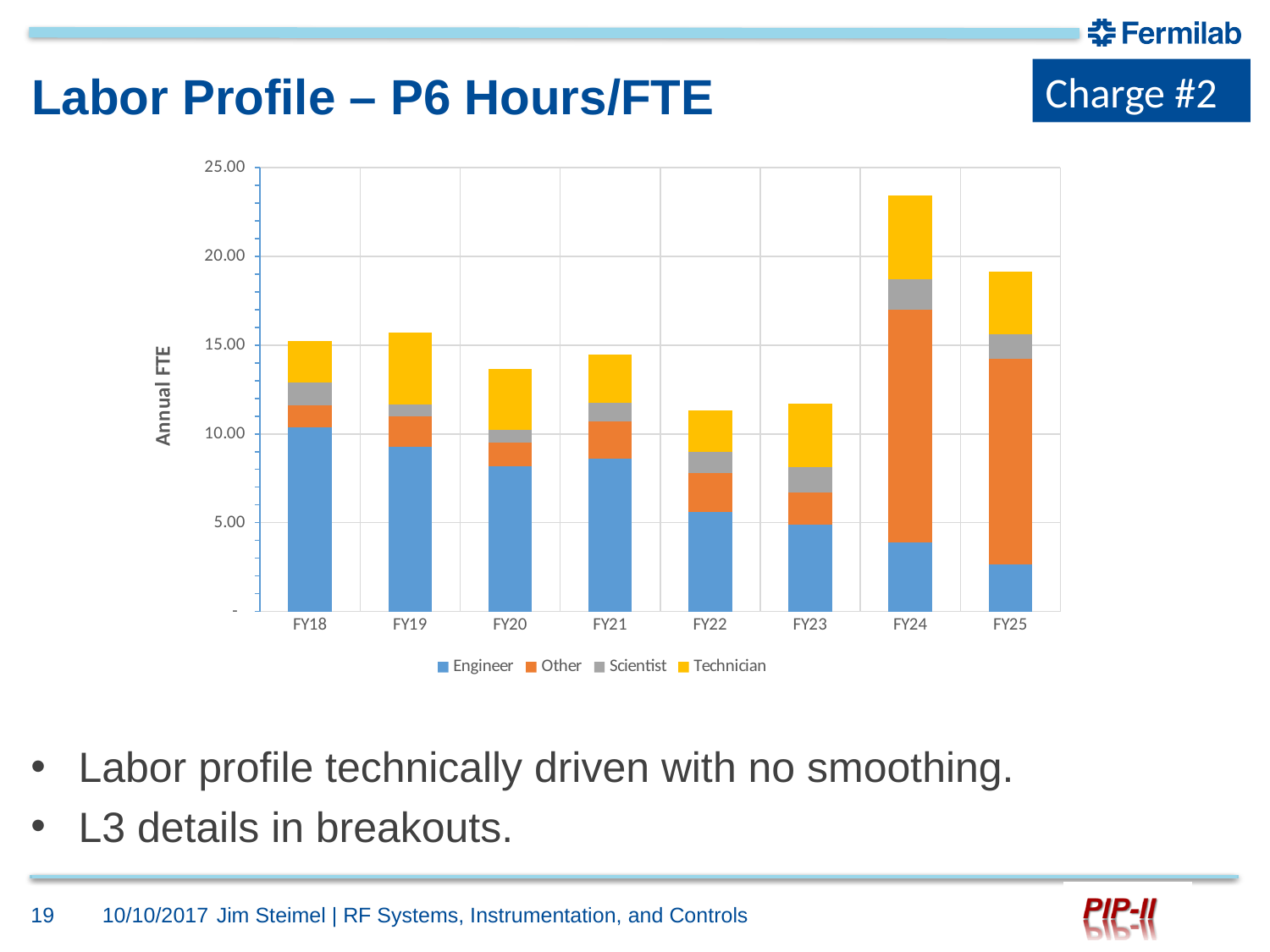
Is the total Annual FTE for FY24 greater or less than 20.00? greater In FY24, which segment is larger, Engineer or Other? Other Which fiscal year has the highest total Annual FTE? FY24 Is the total Annual FTE for FY20 greater or less than 15.00? less How many series does the chart legend list? 4 What is the label on the y axis of the chart? Annual FTE Is the total Annual FTE for FY22 greater or less than 15.00? less How many fiscal years are shown on the x axis of the chart? 8 Which fiscal year has the smallest Engineer segment? FY25 What kind of chart is shown on the slide? Stacked bar chart Which fiscal year has the largest Engineer segment? FY18 Which is larger, the total Annual FTE for FY19 or for FY20? FY19